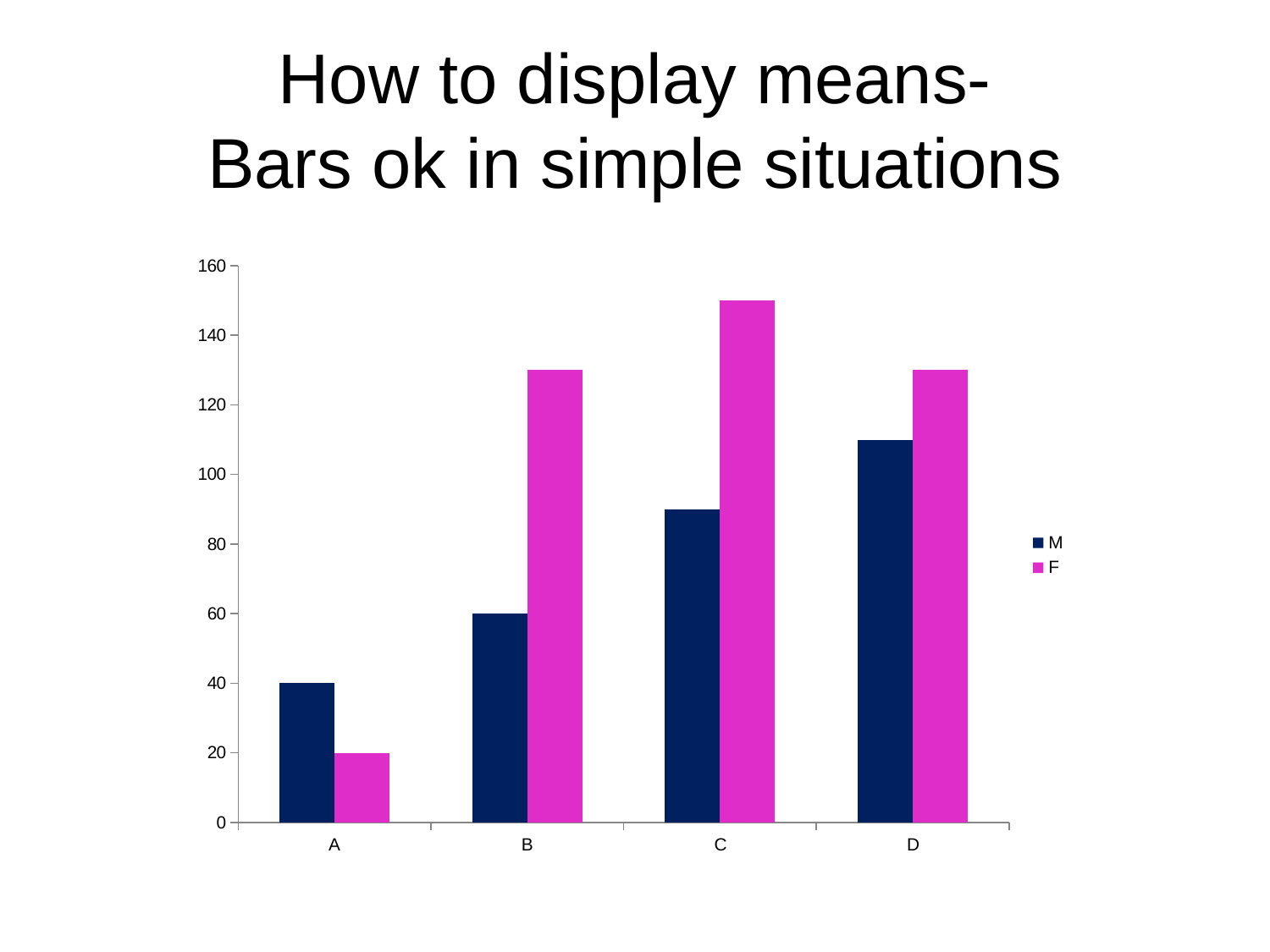
Is the value for F in category C greater or less than 140? greater Which is larger in category D, the M value or the F value? F Is the value for M in category C greater or less than 100? less Which category has the lowest M value? A What is the difference between the M and F values in category A? 20 What is the value for F in category A? 20 What kind of chart is shown on the slide? bar chart How many categories are shown on the x axis? 4 How many series does the legend list? 2 Which category has the highest F value? C What is the value for M in category A? 40 What is the value for M in category B? 60